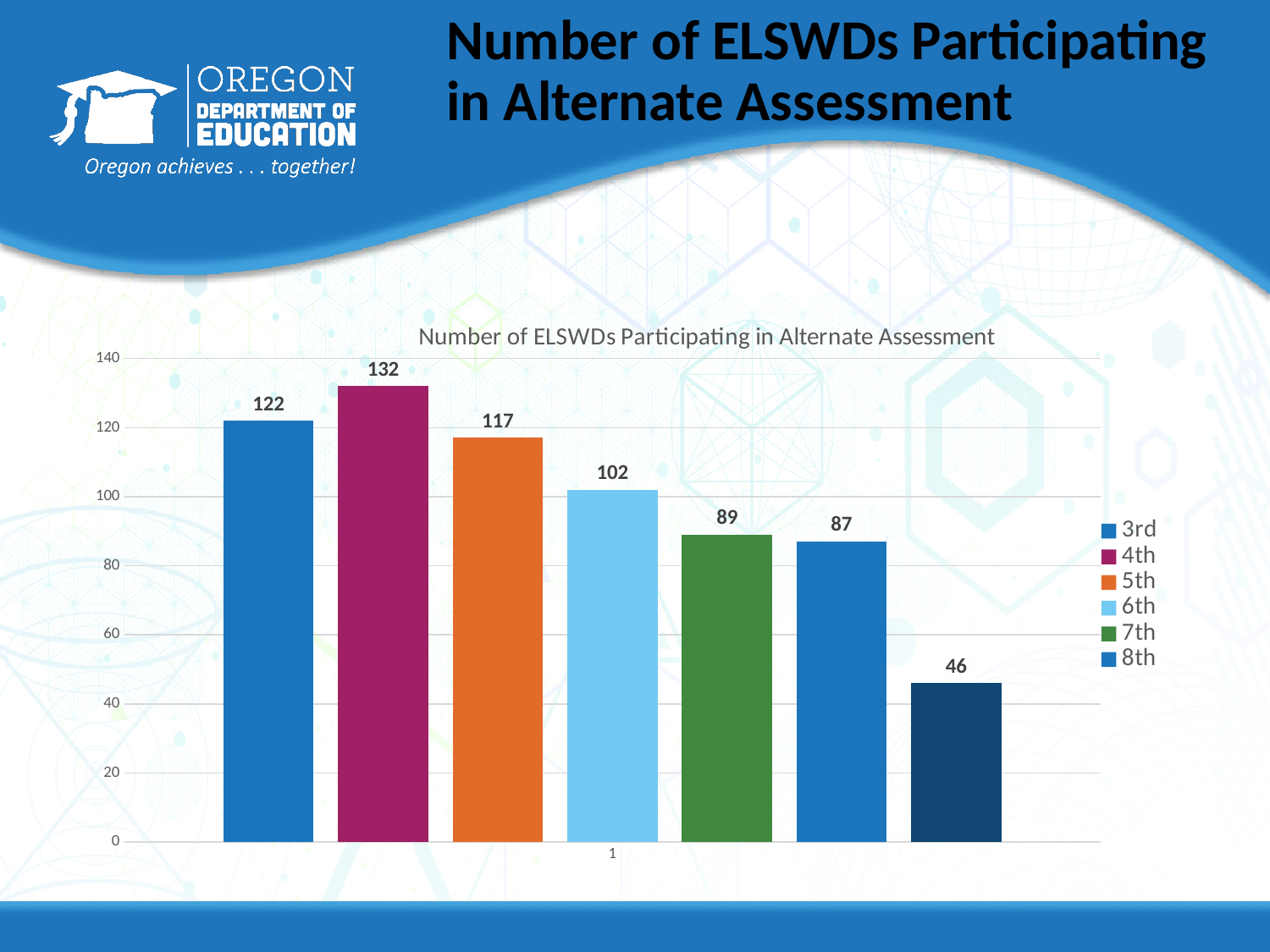
What is the value for 8th grade? 87 What is the lowest value shown on the chart? 46 What is the value for 3rd grade? 122 What is the difference between the values for 4th grade and 3rd grade? 10 What kind of chart is shown on the slide? Bar chart What is the value for 4th grade? 132 How many entries does the legend list? 6 Which grade has the highest number of ELSWDs participating? 4th How many bars are plotted on the chart? 7 What is the difference between the values for 3rd grade and 8th grade? 35 Which is larger, the value for 7th grade or 8th grade? 7th What is the value for 6th grade? 102